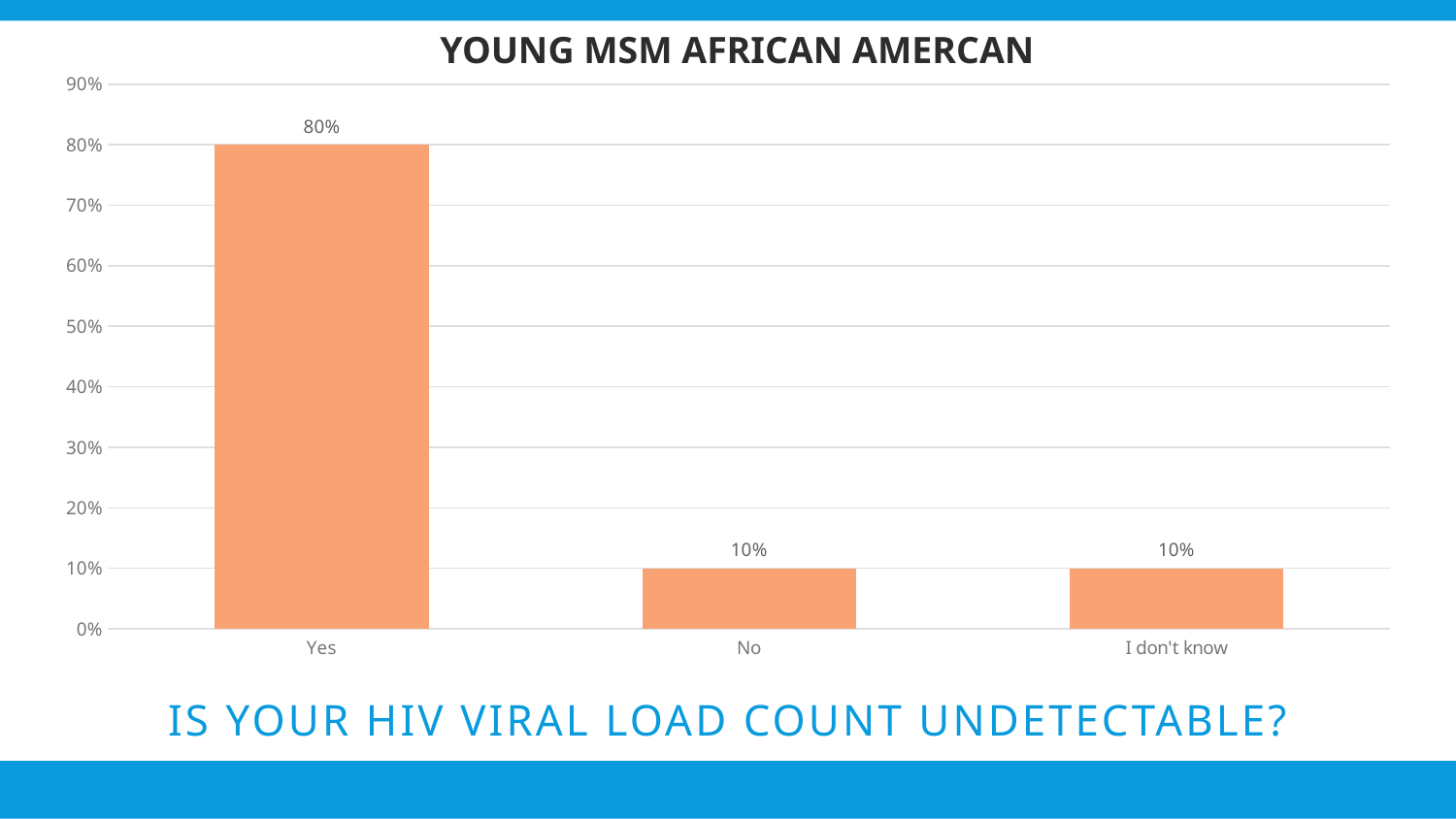
What is the value for No? 10% What is the difference between the values for Yes and No? 70% Is the value for Yes greater or less than 50%? greater Which category has the highest value? Yes Which is larger, the value for Yes or the value for I don't know? Yes What is the value for Yes? 80% What is the value for I don't know? 10% What kind of chart is shown on the slide? bar chart How many categories are shown on the x axis? 3 What question is written below the chart? IS YOUR HIV VIRAL LOAD COUNT UNDETECTABLE? Is the value for No greater or less than 20%? less What is the title of the chart? YOUNG MSM AFRICAN AMERCAN